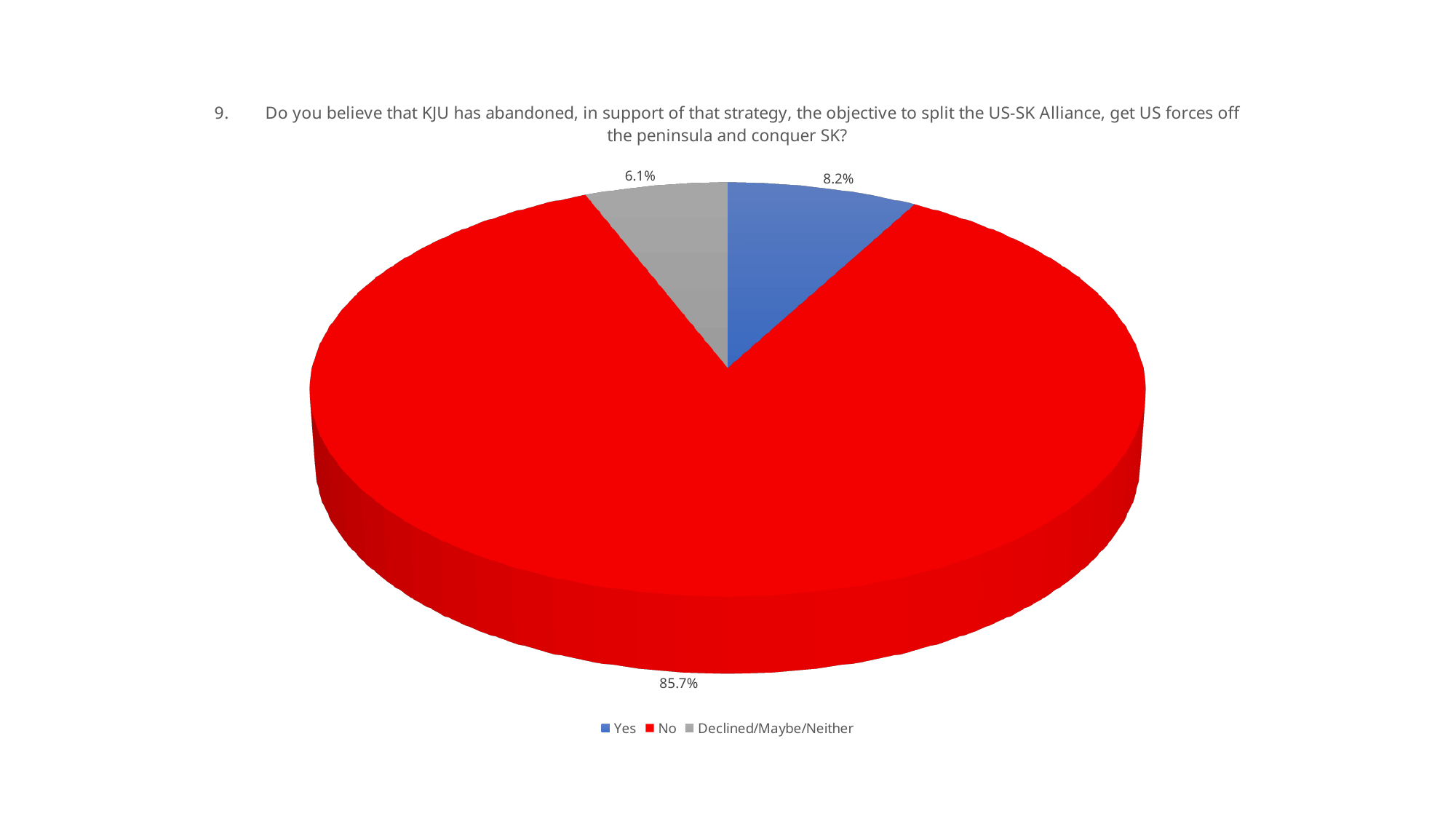
What percentage of respondents are in the "Declined/Maybe/Neither" category? 6.1% What is the difference in percentage points between the "Yes" and "Declined/Maybe/Neither" shares? 2.1 Which response category has the largest share of the pie? No Which category does the grey slice represent? Declined/Maybe/Neither What colour is the slice representing "No"? Red What kind of chart is shown on the slide? Pie chart How many slices does the pie chart have? 3 Which is larger, the share for "Yes" or the share for "Declined/Maybe/Neither"? Yes What is the difference in percentage points between the "No" and "Yes" shares? 77.5 What percentage of respondents answered "No"? 85.7% Which response category has the smallest share of the pie? Declined/Maybe/Neither What percentage of respondents answered "Yes"? 8.2%